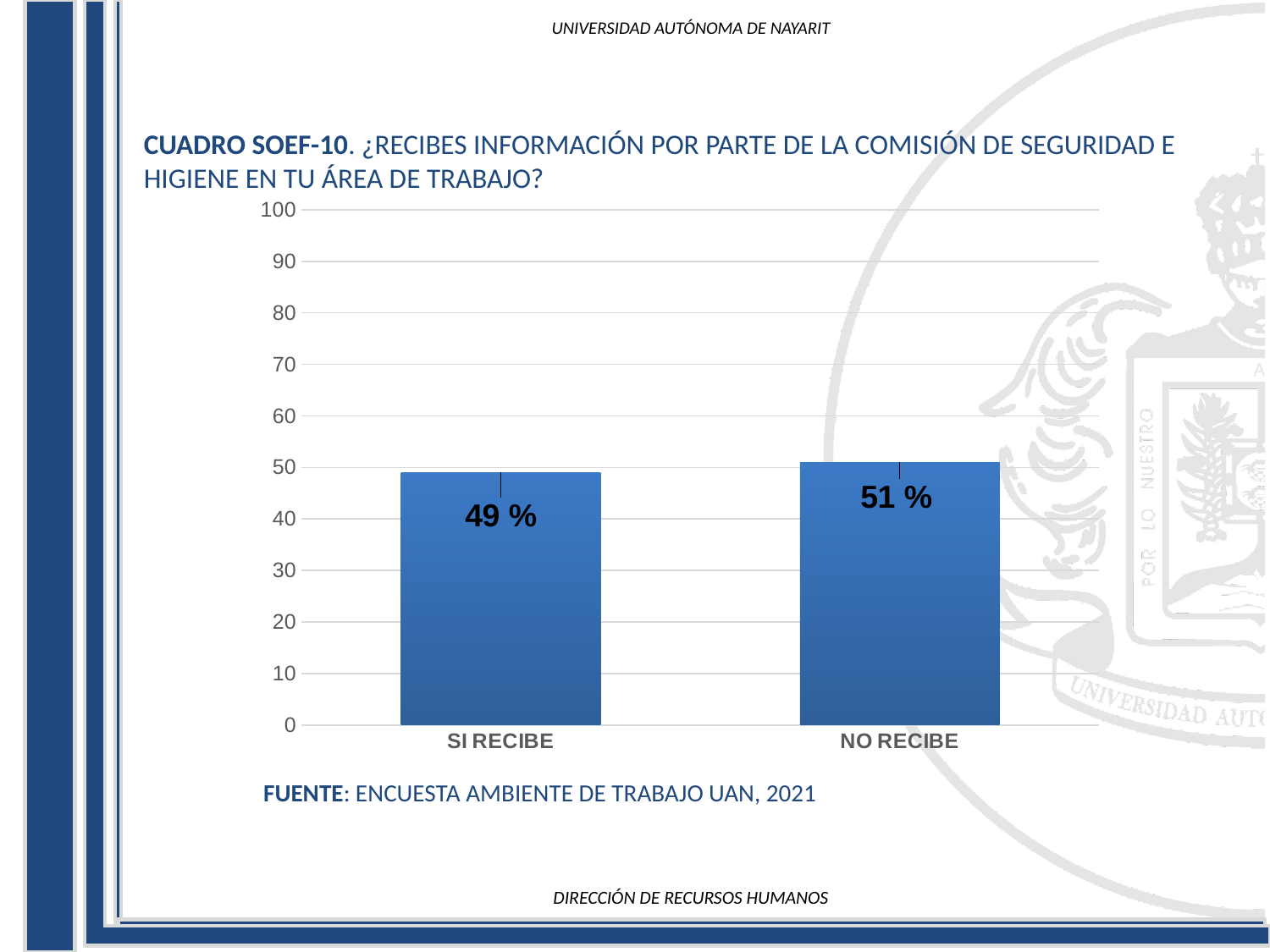
What is the maximum value shown on the y axis? 100 What is the value for SI RECIBE? 49 % Is the value for SI RECIBE greater or less than 50? less What is the total of the two bar values? 100 % Which is larger, the value for SI RECIBE or the value for NO RECIBE? NO RECIBE What is the value for NO RECIBE? 51 % Which category has the lowest value? SI RECIBE How many categories are shown on the x axis? 2 What is the difference between the values for NO RECIBE and SI RECIBE? 2 % Is the value for NO RECIBE greater or less than 60? less Which category has the highest value? NO RECIBE What kind of chart is shown on the slide? bar chart